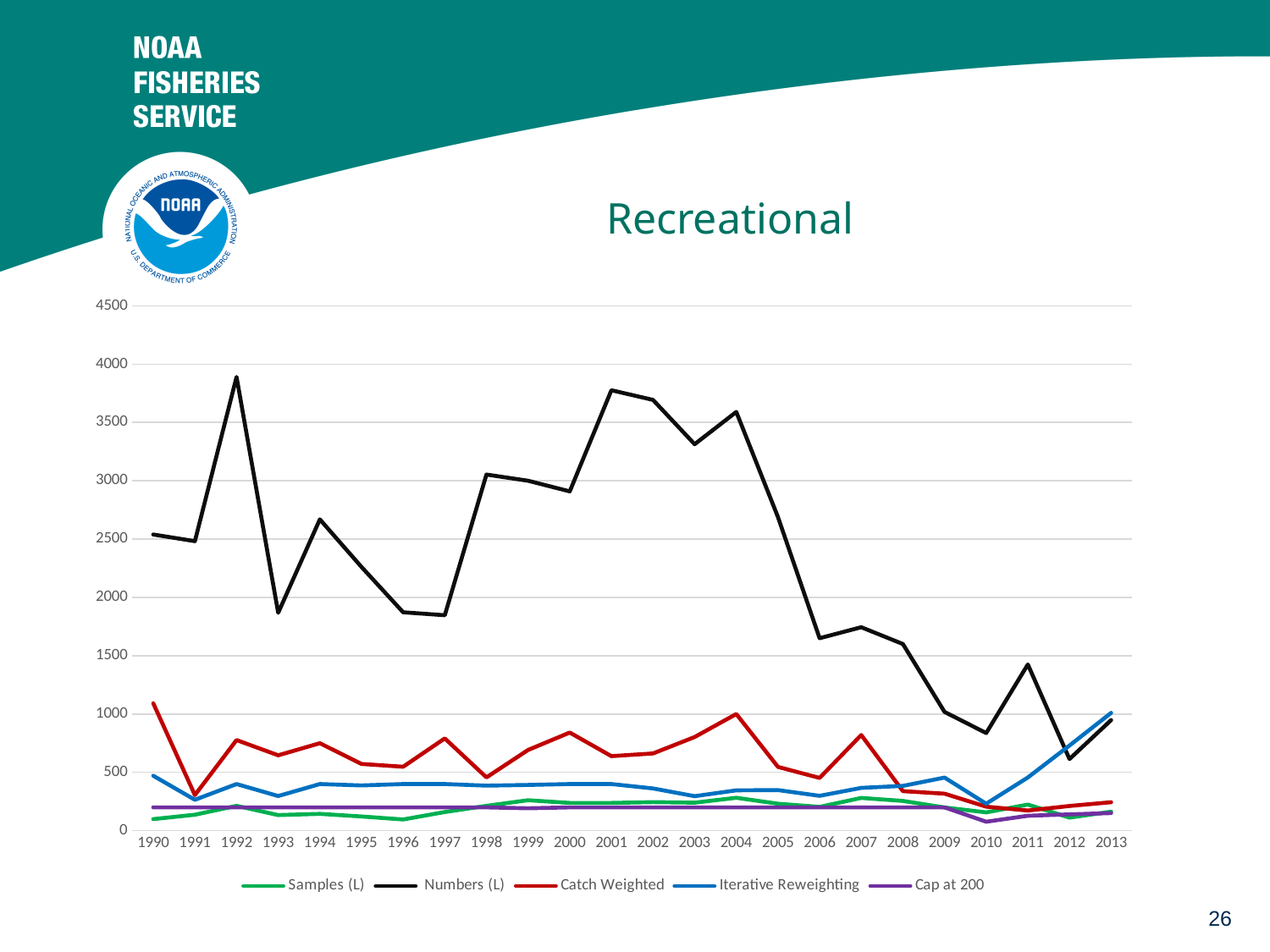
How many series does the legend list? 5 What colour is the Numbers (L) line? black Is the value of Numbers (L) in 1992 greater or less than 3500? greater What is the title of the chart? Recreational In which year is Numbers (L) at its lowest? 2012 What kind of chart is shown on the slide? line chart Which series has the highest value in 2001? Numbers (L) Is the value of Samples (L) in 1990 greater or less than 500? less Is the value of Numbers (L) in 2010 greater or less than 1000? less How many years are plotted along the x axis? 24 Does Numbers (L) rise or fall from 2004 to 2010? fall